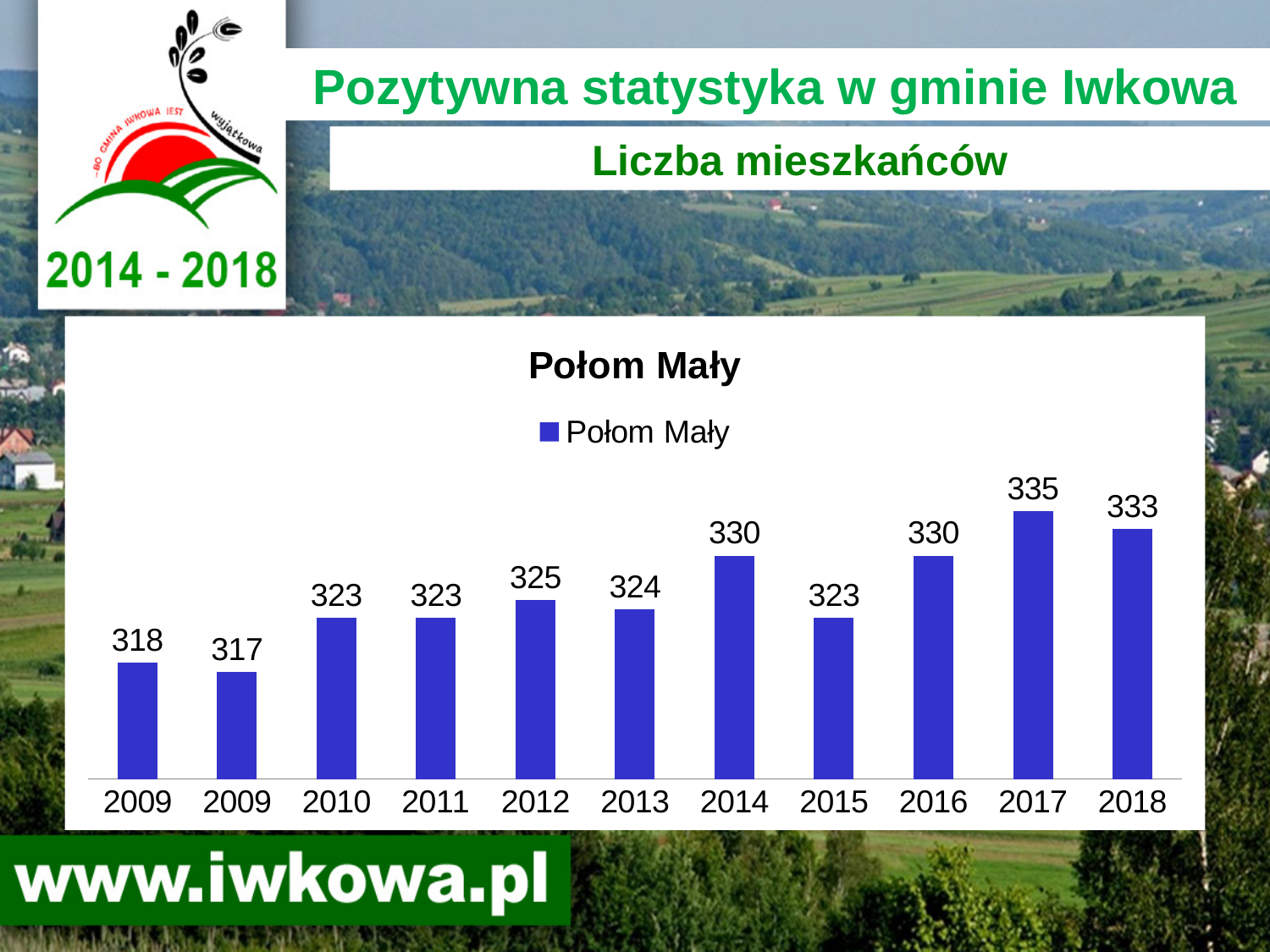
Which year has the highest value in the chart? 2017 What kind of chart is shown on the slide? bar chart What is the value for 2012? 325 How many bars are plotted in the chart? 11 How many series does the chart legend list? 1 What is the value for 2015? 323 What is the lowest value shown in the chart? 317 Which is larger, the value for 2014 or the value for 2015? 2014 What is the difference between the values for 2017 and 2018? 2 What is the value for 2018? 333 Do the values generally rise or fall from 2009 to 2018? rise What is the title of the chart? Połom Mały